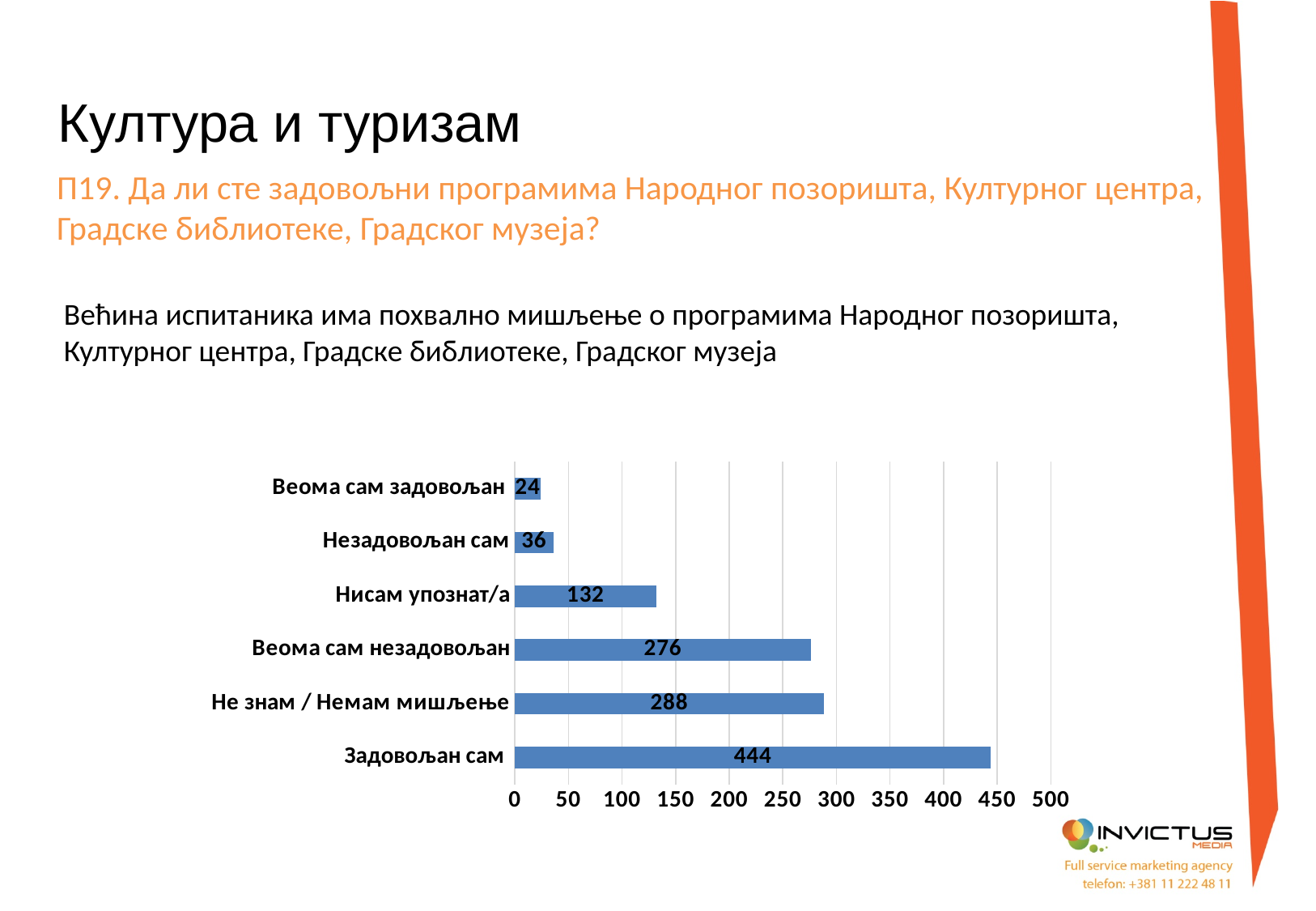
What is the value for "Задовољан сам"? 444 Which category has the highest value? Задовољан сам How many categories are shown in the chart? 6 What kind of chart is shown on the slide? bar chart Is the value for "Не знам / Немам мишљење" greater or less than 250? greater What is the value for "Веома сам задовољан"? 24 What is the difference between the values for "Незадовољан сам" and "Веома сам задовољан"? 12 What is the highest value shown on the x axis? 500 What is the difference between the values for "Задовољан сам" and "Не знам / Немам мишљење"? 156 Which is larger, the value for "Веома сам незадовољан" or the value for "Нисам упознат/а"? Веома сам незадовољан Which category has the lowest value? Веома сам задовољан What is the value for "Нисам упознат/а"? 132